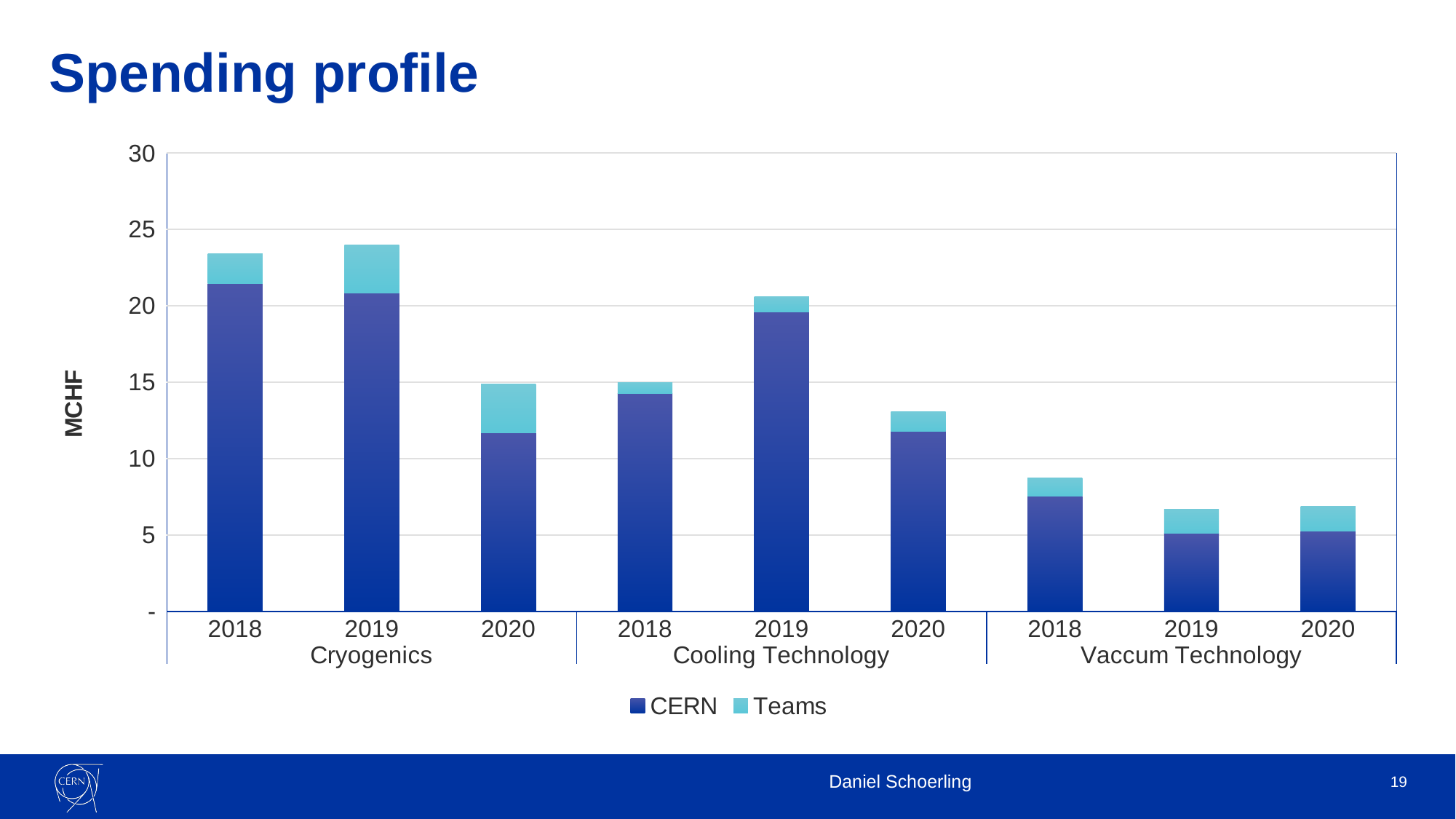
Which has the larger total bar: Cryogenics 2018 or Cooling Technology 2018? Cryogenics 2018 What is the label on the vertical axis? MCHF Which has the larger total bar: Cooling Technology 2019 or Cooling Technology 2020? Cooling Technology 2019 What kind of chart is shown on the slide? Stacked bar chart How many bars are plotted in the chart? 9 Is the total bar height for Cryogenics in 2018 greater or less than 20? greater Within Cryogenics, does the total bar height rise or fall from 2019 to 2020? fall Is the CERN portion for Cryogenics in 2020 greater or less than 10? greater Is the total bar height for Vaccum Technology in 2018 greater or less than 10? less Which two series are listed in the legend? CERN and Teams How many series does the legend list? 2